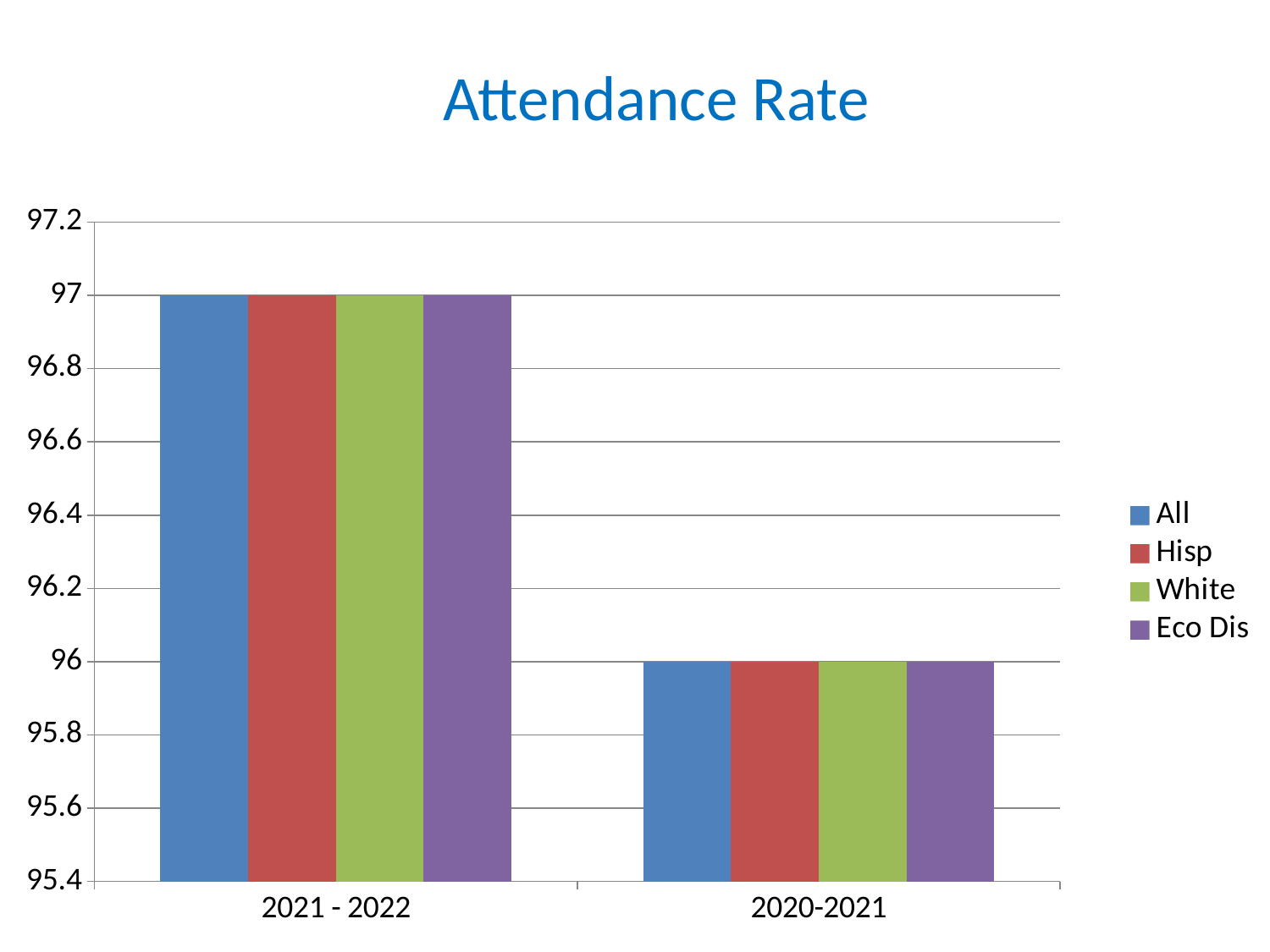
How many categories are shown on the x axis? 2 Which legend entry is shown in purple? Eco Dis What is the title of the chart? Attendance Rate How many series does the legend list? 4 What is the attendance rate for Eco Dis in 2020-2021? 96 What is the attendance rate for All in 2021 - 2022? 97 What is the attendance rate for White in 2020-2021? 96 Which category has the higher attendance rate for All, 2021 - 2022 or 2020-2021? 2021 - 2022 What kind of chart is shown on the slide? bar chart What is the difference between the All attendance rate in 2021 - 2022 and in 2020-2021? 1 What is the attendance rate for Hisp in 2021 - 2022? 97 Is the value for Hisp in 2020-2021 greater or less than 96.4? less